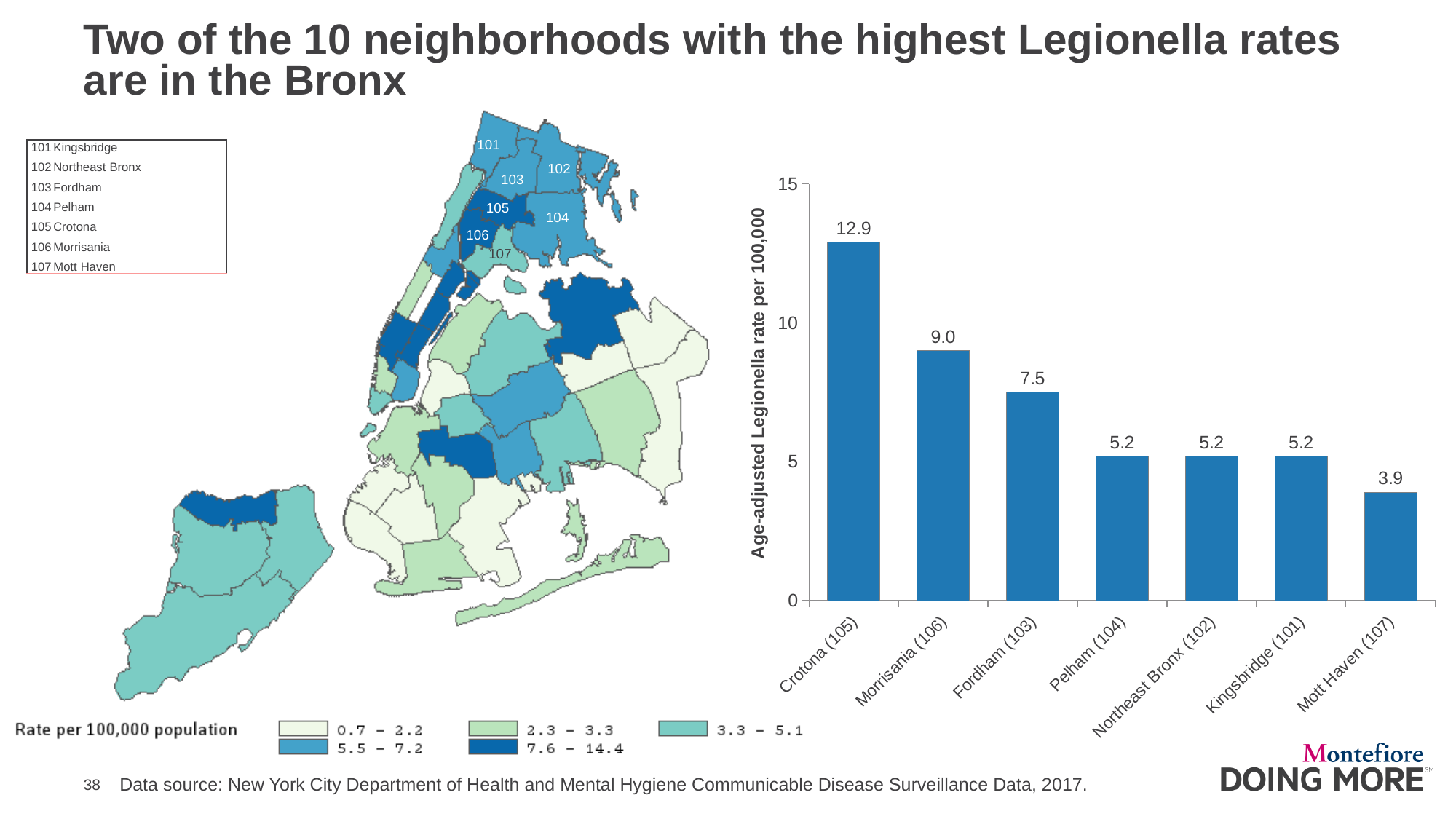
Is the Legionella rate for Fordham (103) in the bar chart greater or less than 5? greater Do the values in the bar chart rise or fall from left to right? fall In the bar chart, which has a higher Legionella rate, Morrisania (106) or Pelham (104)? Morrisania (106) What kind of chart is used to show the age-adjusted Legionella rates? bar chart What is the age-adjusted Legionella rate per 100,000 for Mott Haven (107) in the bar chart? 3.9 Which neighborhood has the highest age-adjusted Legionella rate in the bar chart? Crotona (105) What is the difference between the Legionella rates for Crotona (105) and Fordham (103) in the bar chart? 5.4 What is the age-adjusted Legionella rate per 100,000 for Morrisania (106) in the bar chart? 9.0 What is the age-adjusted Legionella rate per 100,000 for Crotona (105) in the bar chart? 12.9 How many neighborhoods are shown in the bar chart? 7 Which neighborhood has the lowest age-adjusted Legionella rate in the bar chart? Mott Haven (107) What is the label of the y axis in the bar chart? Age-adjusted Legionella rate per 100,000